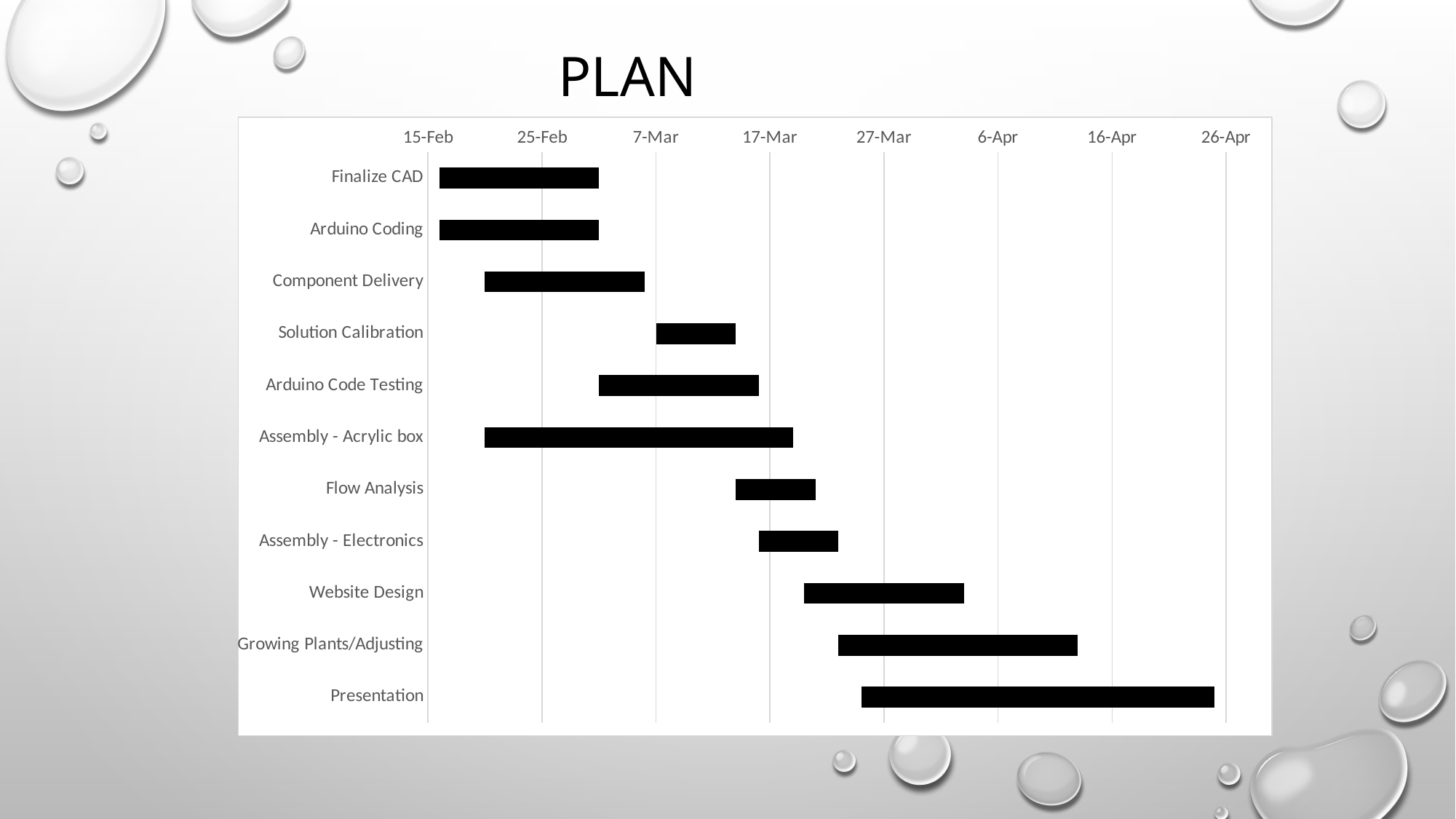
Does the Finalize CAD bar end before or after 7-Mar? before Does the Website Design bar end before or after 6-Apr? before What kind of chart is shown on the slide? Bar chart (Gantt chart) What is the title of the slide? PLAN Does the Assembly - Acrylic box bar end before or after 17-Mar? after Which task has the longest bar on the chart? Presentation What is the earliest date shown on the horizontal axis? 15-Feb How many tasks are listed on the chart? 11 Which bar is longer, Component Delivery or Solution Calibration? Component Delivery Which task finishes last on the chart? Presentation Which task is listed first (at the top) of the chart? Finalize CAD